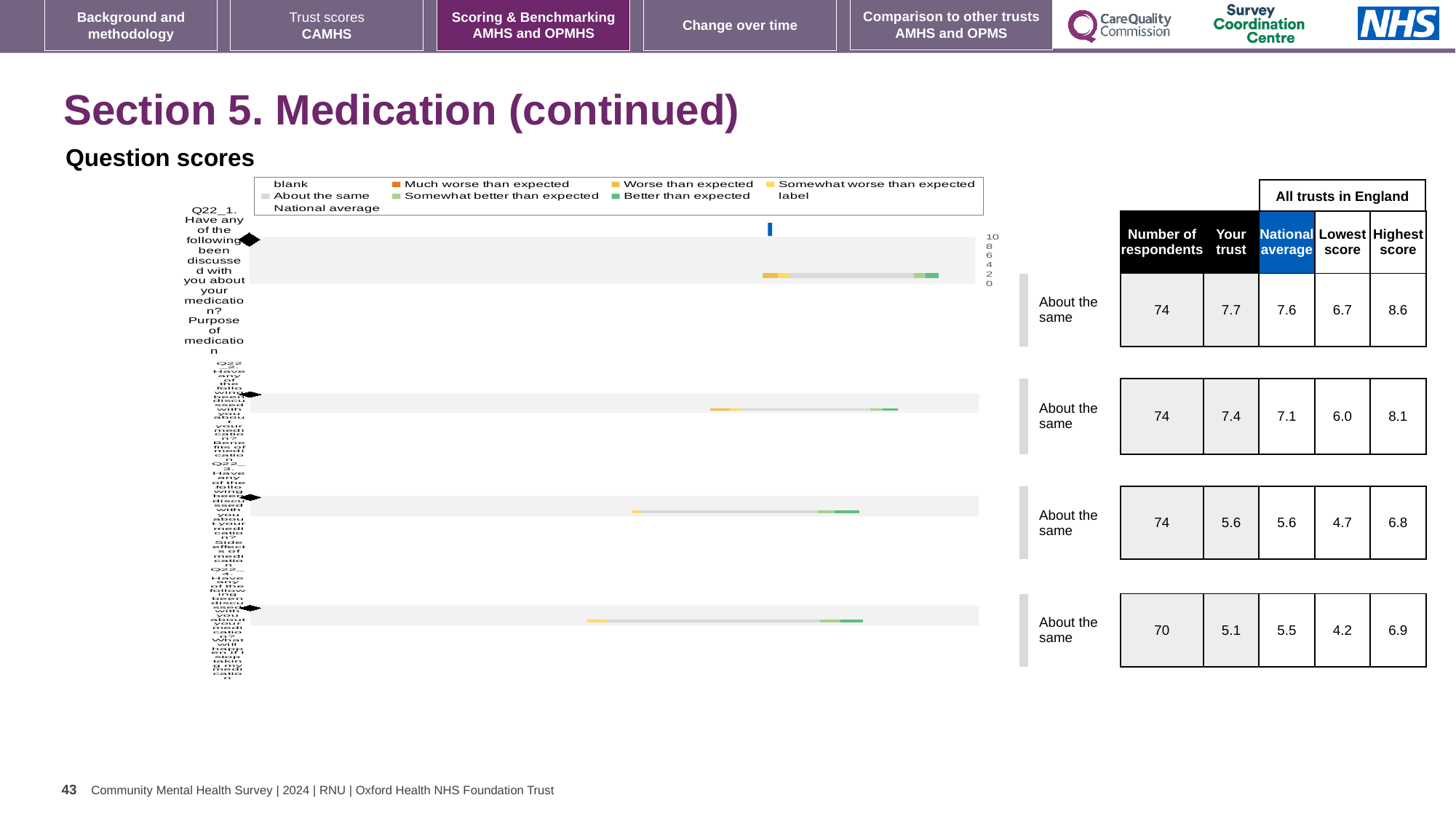
Is the 'Your trust' marker for Q22_1 (Purpose of medication) greater or less than 6 on the axis? greater How many question bars are plotted in the chart? 4 How many respondents are shown for the bottom (fourth) question? 70 For the second question from the top, which is larger: the 'Your trust' score or the national average? Your trust Which question has the highest 'Your trust' score? Q22_1 Purpose of medication What kind of chart is shown under 'Question scores'? Bar chart What is the national average for Q22_1 (Purpose of medication)? 7.6 What is the 'Your trust' score for Q22_1 (Purpose of medication)? 7.7 What is the lowest 'Your trust' score shown among the four questions? 5.1 What is the lowest score across all trusts in England for the third question from the top? 4.7 For Q22_1 (Purpose of medication), what is the difference between the highest score and the lowest score across all trusts? 1.9 What benchmark category is shown for all four questions in the chart? About the same